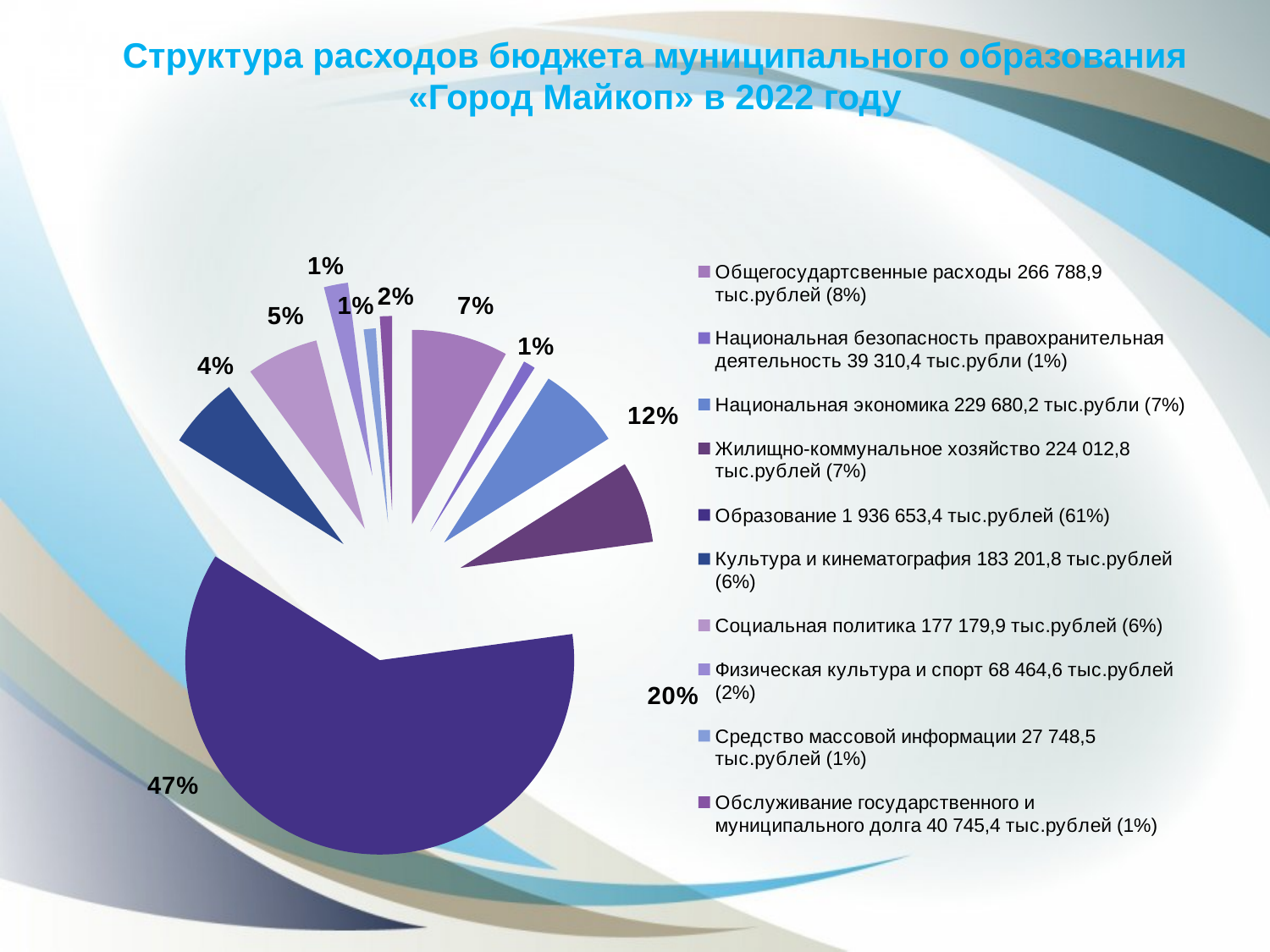
What is the difference between the largest slice label (47%) and the 20% slice label? 27% What is the title of the slide containing the pie chart? Структура расходов бюджета муниципального образования «Город Майкоп» в 2022 году What data label is shown on the slice for Жилищно-коммунальное хозяйство? 20% What is the smallest percentage shown as a data label on the pie chart? 1% How many slices does the pie chart have? 10 What is the data label on the largest slice of the pie chart? 47% What data label is shown on the slice for Национальная экономика? 12% How many entries does the legend of the pie chart list? 10 What data label is shown on the slice for Образование? 47% What kind of chart is shown on the slide? pie chart Which slice is larger: the one labelled 12% or the one labelled 20%? 20% According to the legend, what amount is given for Образование? 1 936 653,4 тыс.рублей